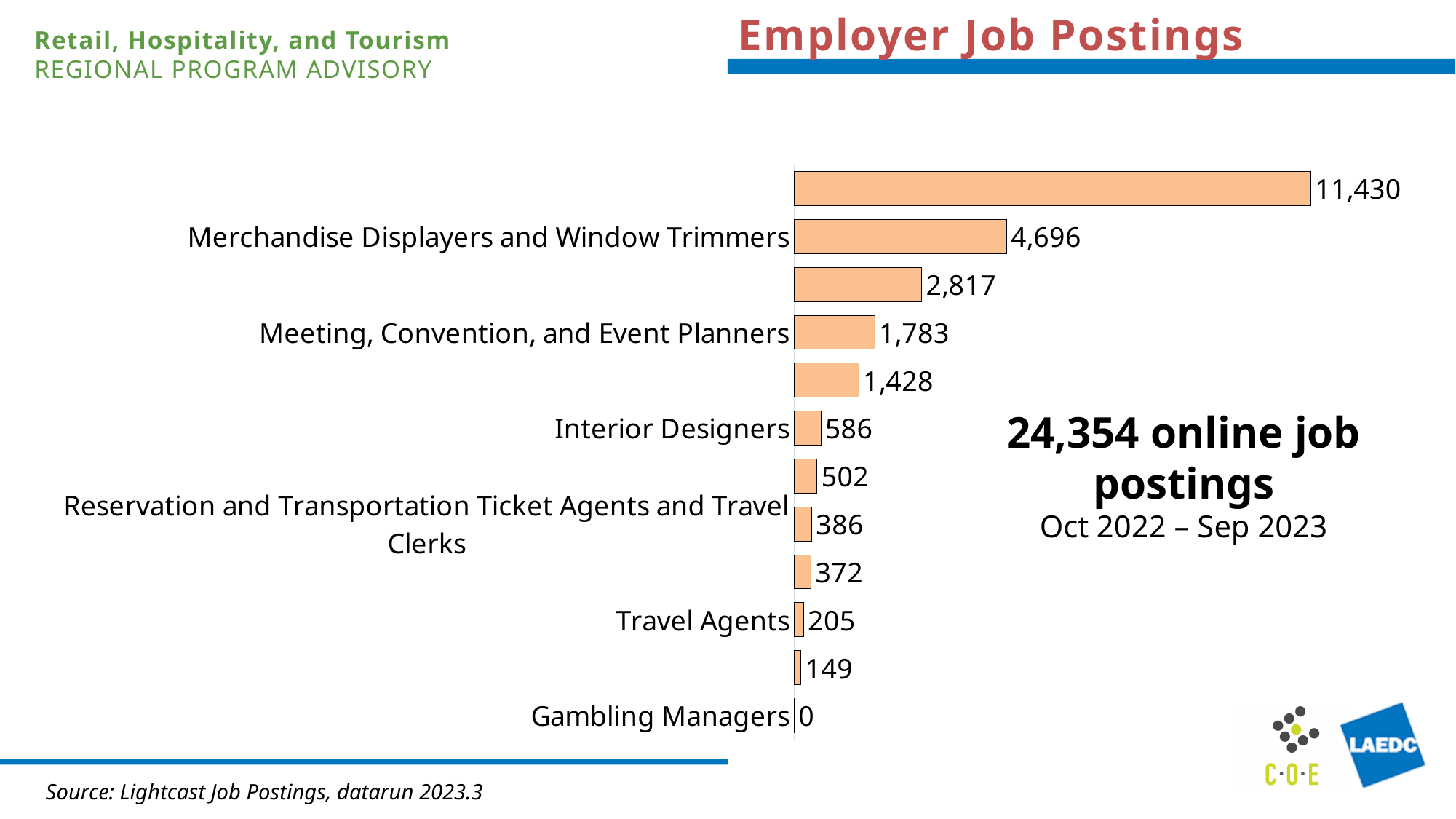
How many job postings are shown for Merchandise Displayers and Window Trimmers? 4,696 How many bars does the chart contain? 12 Which is larger, the value for Interior Designers or the value for Travel Agents? Interior Designers What is the value for Meeting, Convention, and Event Planners? 1,783 What kind of chart is shown on the slide? bar chart What is the value for Interior Designers? 586 Which category has the lowest value in the chart? Gambling Managers What is the difference between the values for Merchandise Displayers and Window Trimmers and Meeting, Convention, and Event Planners? 2,913 What is the value for Reservation and Transportation Ticket Agents and Travel Clerks? 386 What is the largest value shown on any bar in the chart? 11,430 What total number of online job postings is stated on the slide? 24,354 What is the value for Travel Agents? 205